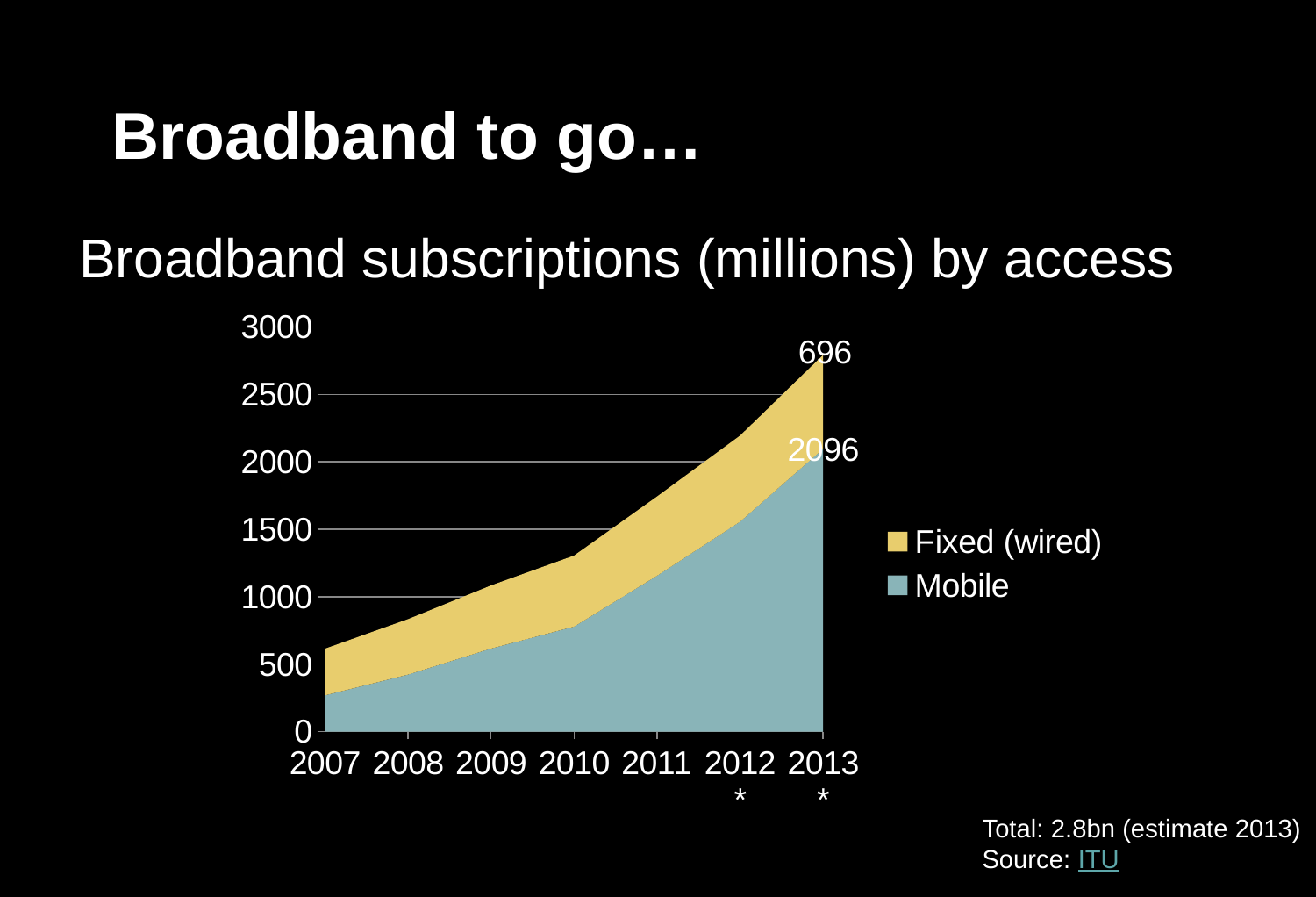
What is the value for Mobile in 2013? 2096 What kind of chart is this? Stacked area chart In 2013, which is larger: Mobile or Fixed (wired)? Mobile How many series does the legend list? 2 Which series is shown in yellow? Fixed (wired) What is the value for Fixed (wired) in 2013? 696 What is the title of the chart? Broadband subscriptions (millions) by access Do the total broadband subscriptions rise or fall from 2007 to 2013? Rise Is the value for Mobile in 2007 greater or less than 500? less How many years are shown on the x axis? 7 What is the total of the stacked values for 2013? 2792 What is the difference between the Mobile and Fixed (wired) values in 2013? 1400